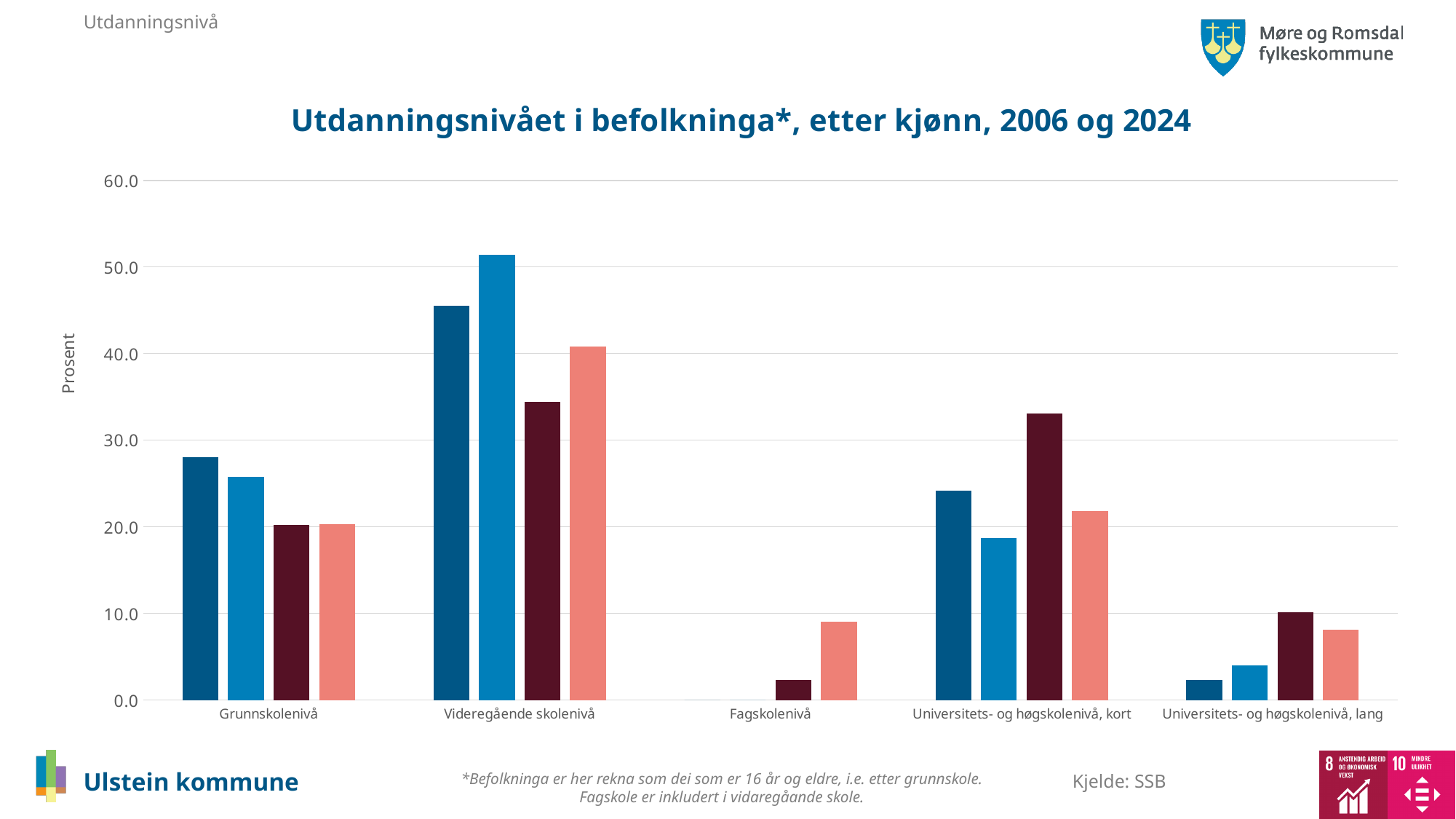
Is the dark blue bar for Grunnskolenivå greater or less than 30? less Is the dark maroon bar for Universitets- og høgskolenivå, kort greater or less than 30? greater Which category contains the tallest bar in the chart? Videregående skolenivå Which category has the lowest bars overall in the chart? Fagskolenivå What kind of chart is shown on the slide? bar chart What is the title of the chart? Utdanningsnivået i befolkninga*, etter kjønn, 2006 og 2024 Is the light blue bar for Videregående skolenivå greater or less than 50? greater What is the label on the vertical axis of the chart? Prosent Which is larger: the dark blue bar for Grunnskolenivå or the dark blue bar for Videregående skolenivå? Videregående skolenivå How many education-level categories are shown on the x axis? 5